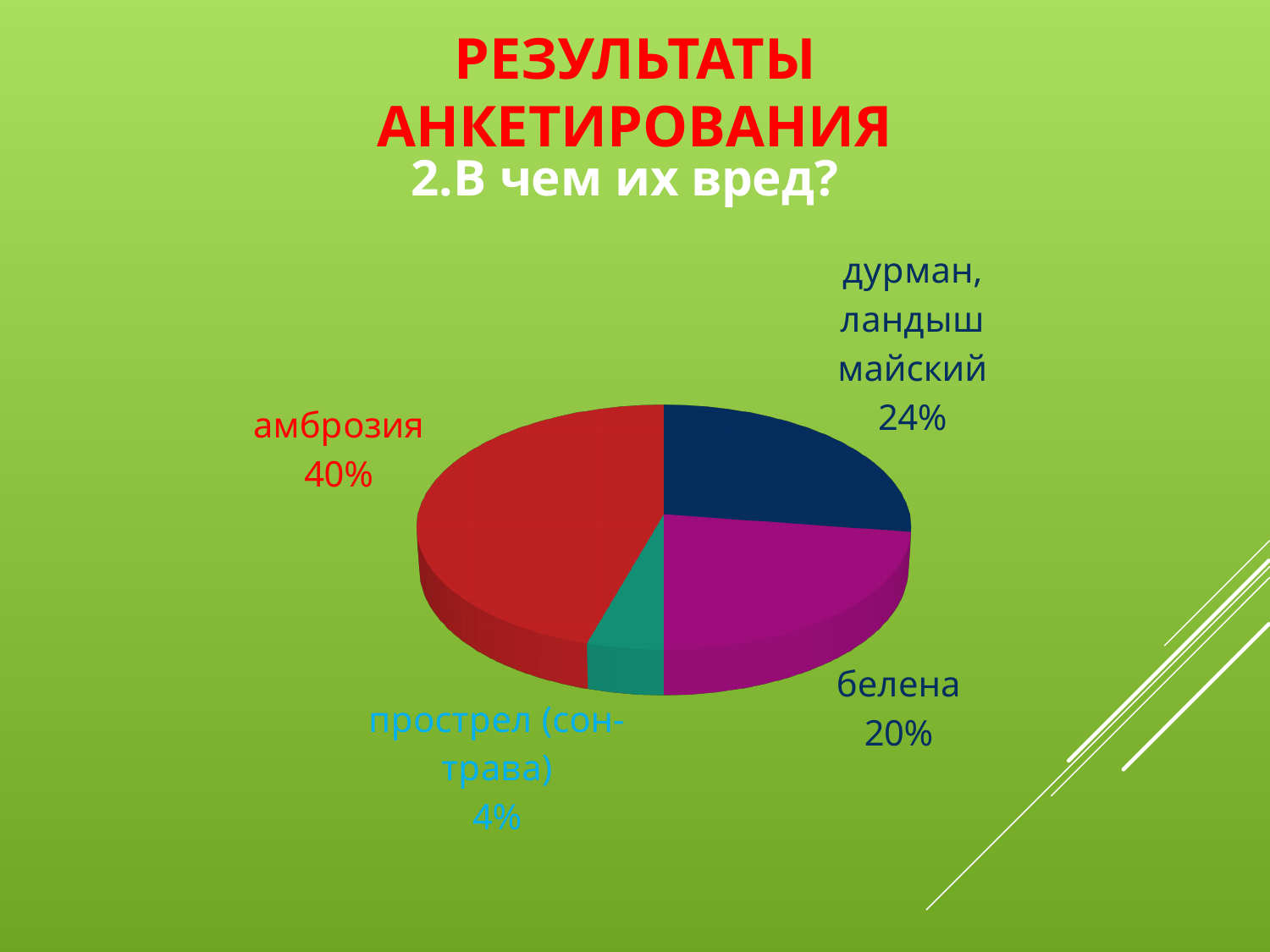
Which is larger, the share of дурман, ландыш майский or the share of белена? дурман, ландыш майский What share of the pie does прострел (сон-трава) have? 4% Which category has the largest slice of the pie? амброзия What is the difference between the shares of амброзия and белена? 20% Which category has the smallest slice of the pie? прострел (сон-трава) What is the title of the chart? 2.В чем их вред? What share of the pie does дурман, ландыш майский have? 24% How many categories are shown in the pie chart? 4 What is the difference between the shares of дурман, ландыш майский and прострел (сон-трава)? 20% What kind of chart is shown on the slide? pie chart What share of the pie does белена have? 20% What share of the pie does амброзия have? 40%